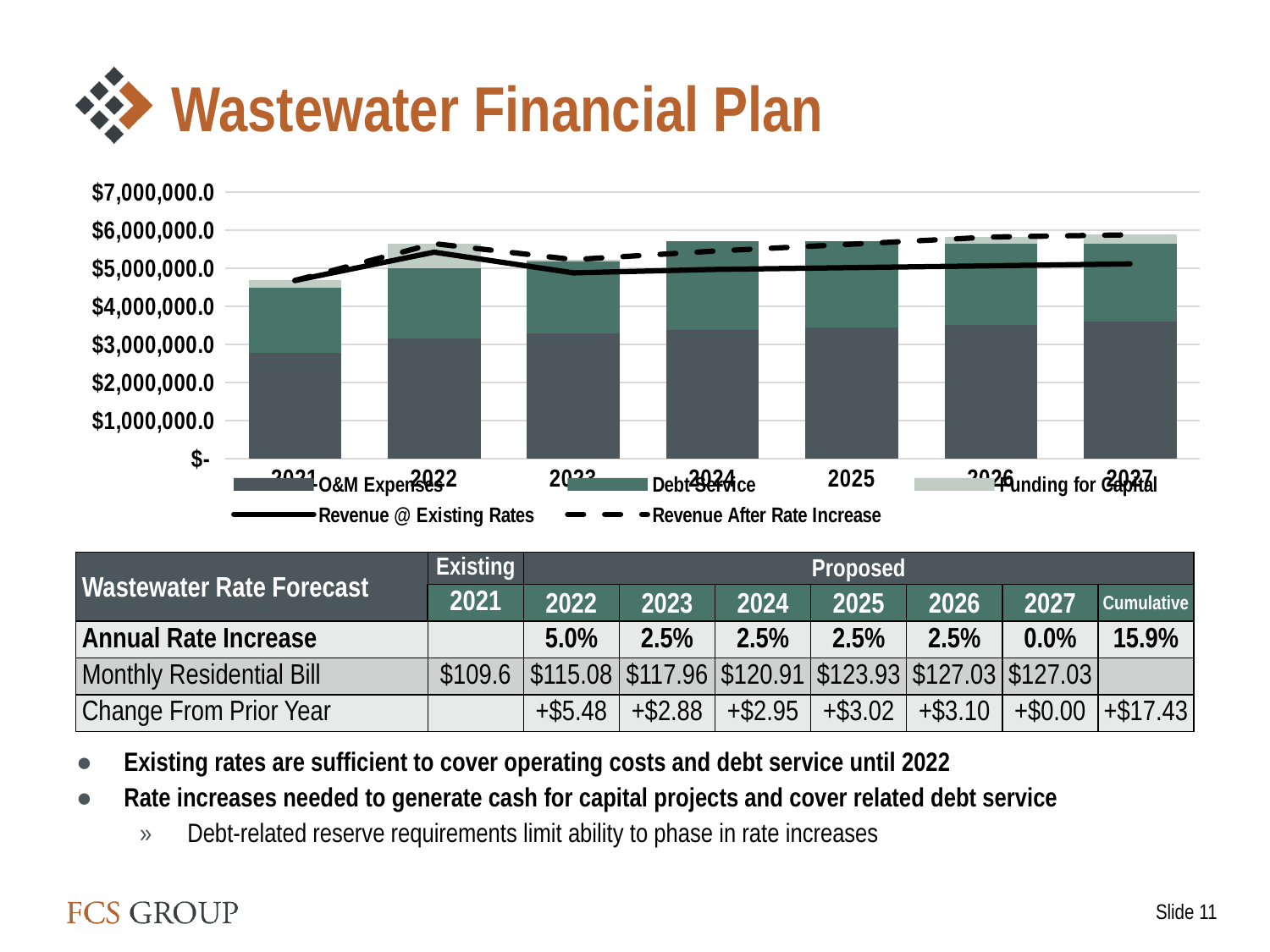
Is the total stacked bar for 2027 greater or less than $5,000,000.0? greater Is the O&M Expenses value for 2027 greater or less than $3,000,000.0? greater Which year has the larger total stacked bar, 2021 or 2022? 2022 Is the O&M Expenses value for 2021 greater or less than $3,000,000.0? less What kind of chart is shown on the slide? A stacked bar chart with line series How many years are plotted along the x axis of the chart? 7 Which year has the lowest total stacked bar in the chart? 2021 How many series does the chart legend list? 5 Do the O&M Expenses values rise or fall from 2021 to 2027? rise What is the highest value shown on the chart's y axis? $7,000,000.0